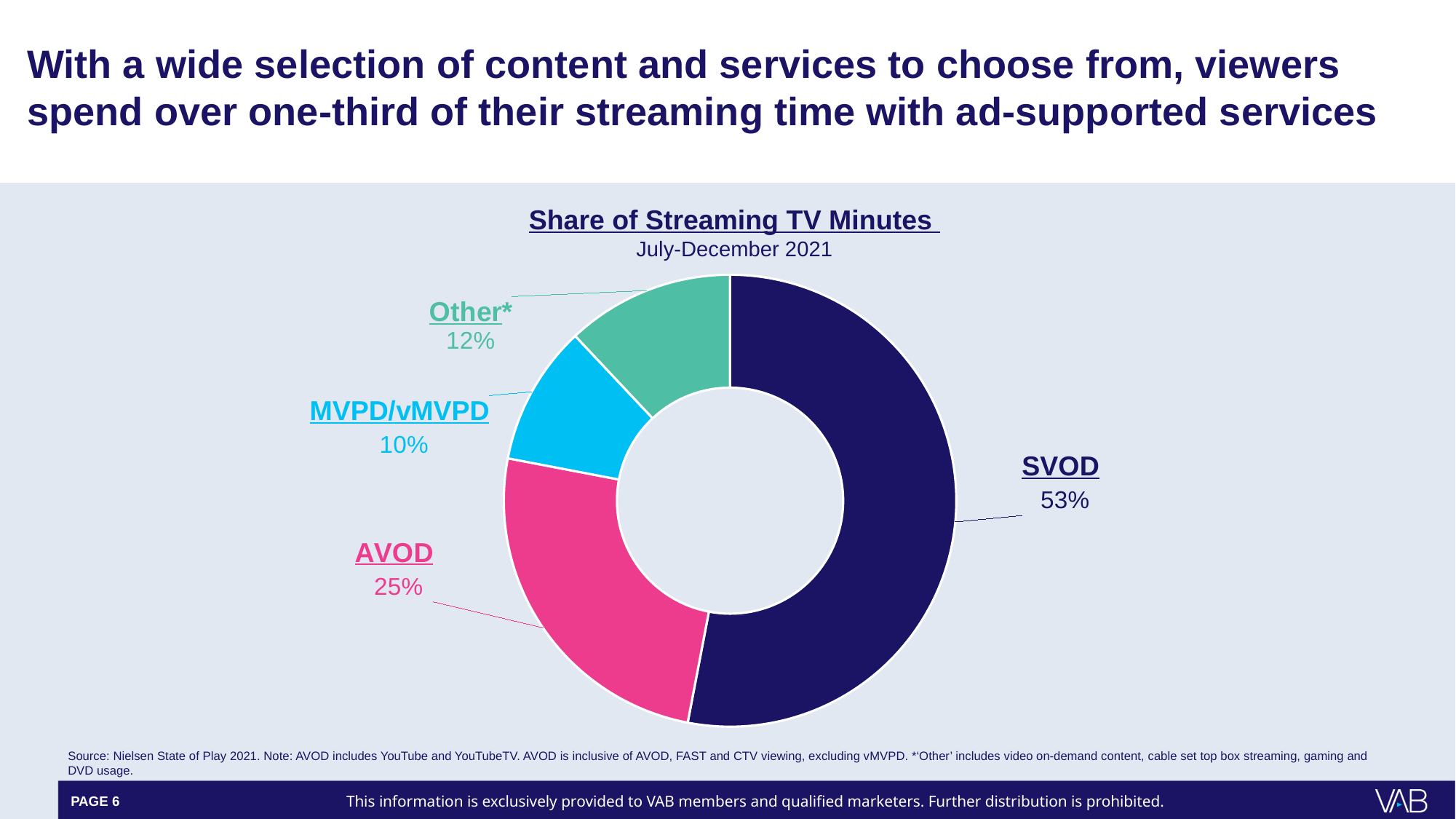
What kind of chart is shown on the slide? Pie chart (donut) What share of streaming TV minutes does SVOD account for? 53% What is the difference in share between SVOD and AVOD? 28 percentage points Which category has the smallest share of streaming TV minutes? MVPD/vMVPD How many categories are shown in the chart? 4 What share of streaming TV minutes does Other* account for? 12% What is the title of the chart? Share of Streaming TV Minutes What share of streaming TV minutes does AVOD account for? 25% What time period does the chart cover? July-December 2021 Which category has the largest share of streaming TV minutes? SVOD What share of streaming TV minutes does MVPD/vMVPD account for? 10% Which has a larger share, Other* or MVPD/vMVPD? Other*